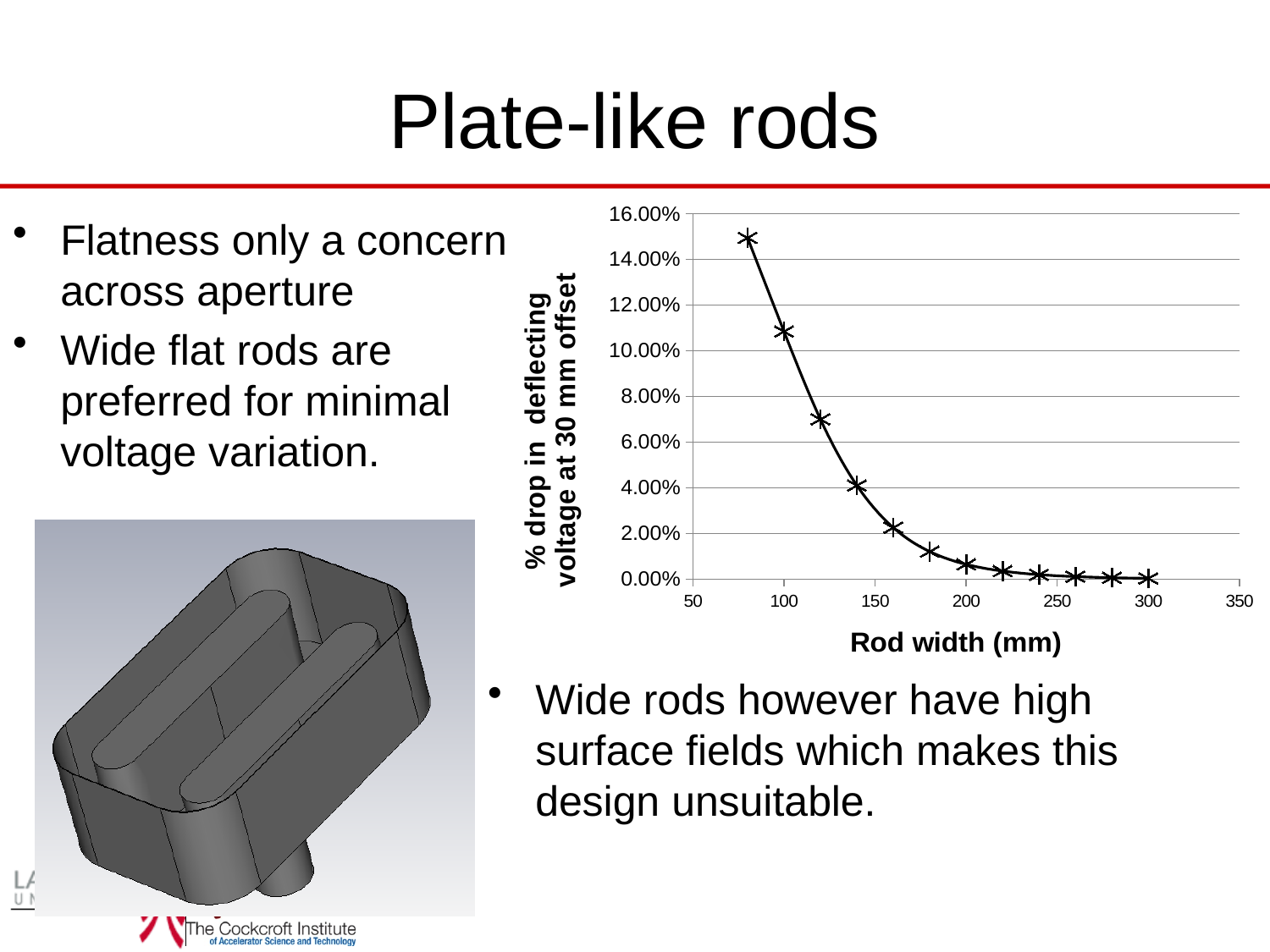
How many data points are plotted on the chart? 12 Is the % drop at a rod width of 140 mm greater or less than 6.00%? less Is the % drop at a rod width of 120 mm greater or less than 8.00%? less Is the % drop at a rod width of 100 mm greater or less than 10.00%? greater What is the label of the y axis of the chart? % drop in deflecting voltage at 30 mm offset What kind of chart is shown on the slide? Line chart with markers (scatter plot) Which rod width has the larger % drop in deflecting voltage, 100 mm or 160 mm? 100 mm What is the label of the x axis of the chart? Rod width (mm) Does the % drop in deflecting voltage rise or fall as rod width increases? Fall